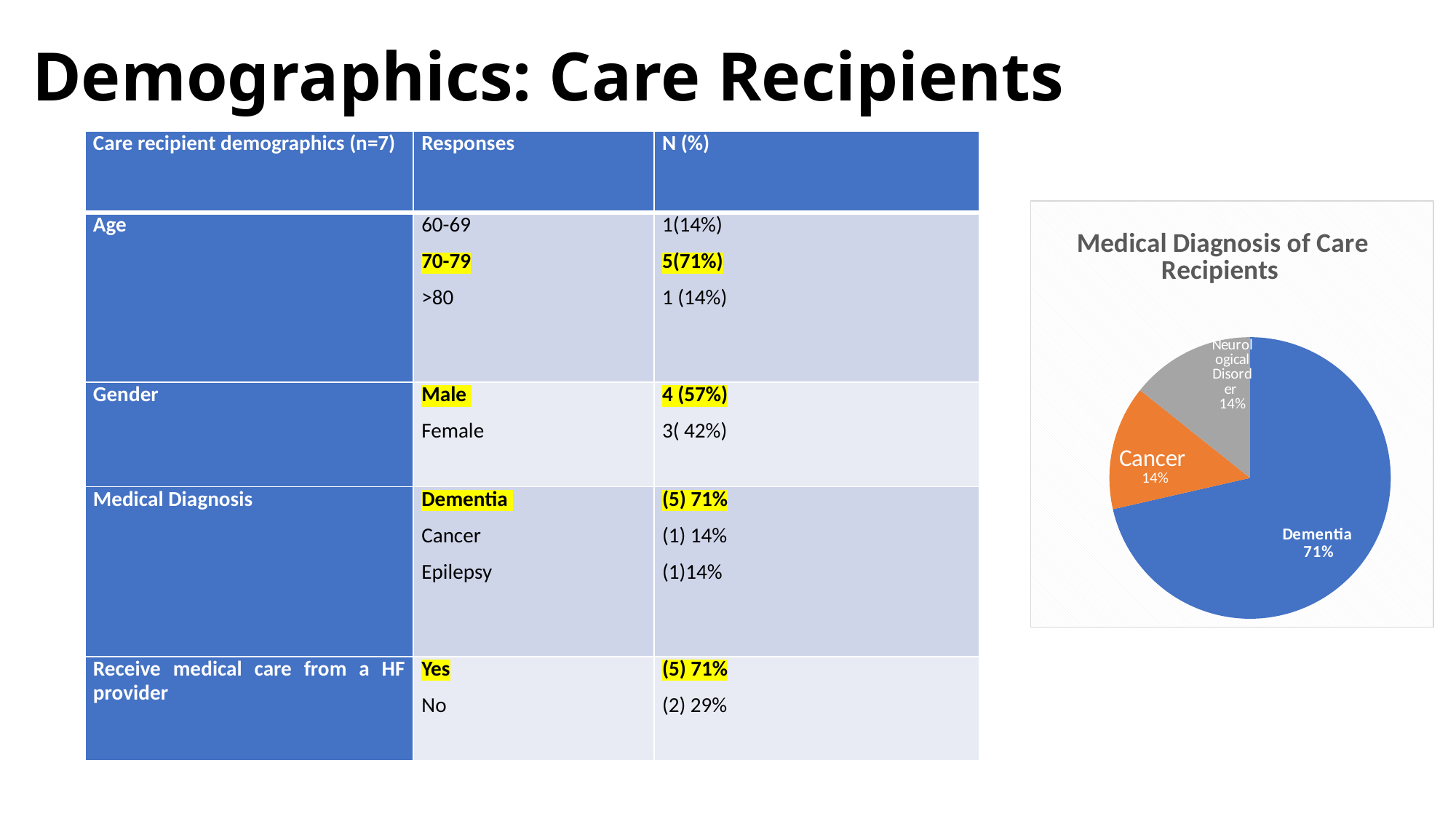
What kind of chart is shown on the slide? pie chart What colour is the Dementia slice in the pie chart? blue What share of the pie chart is Neurological Disorder? 14% What share of the pie chart is Cancer? 14% What share of the pie chart is Dementia? 71% Which slice of the pie chart is the largest? Dementia What is the difference in percentage points between the Dementia slice and the Cancer slice? 57 What is the title of the pie chart? Medical Diagnosis of Care Recipients How many slices does the pie chart have? 3 In the pie chart, which is larger, Dementia or Cancer? Dementia